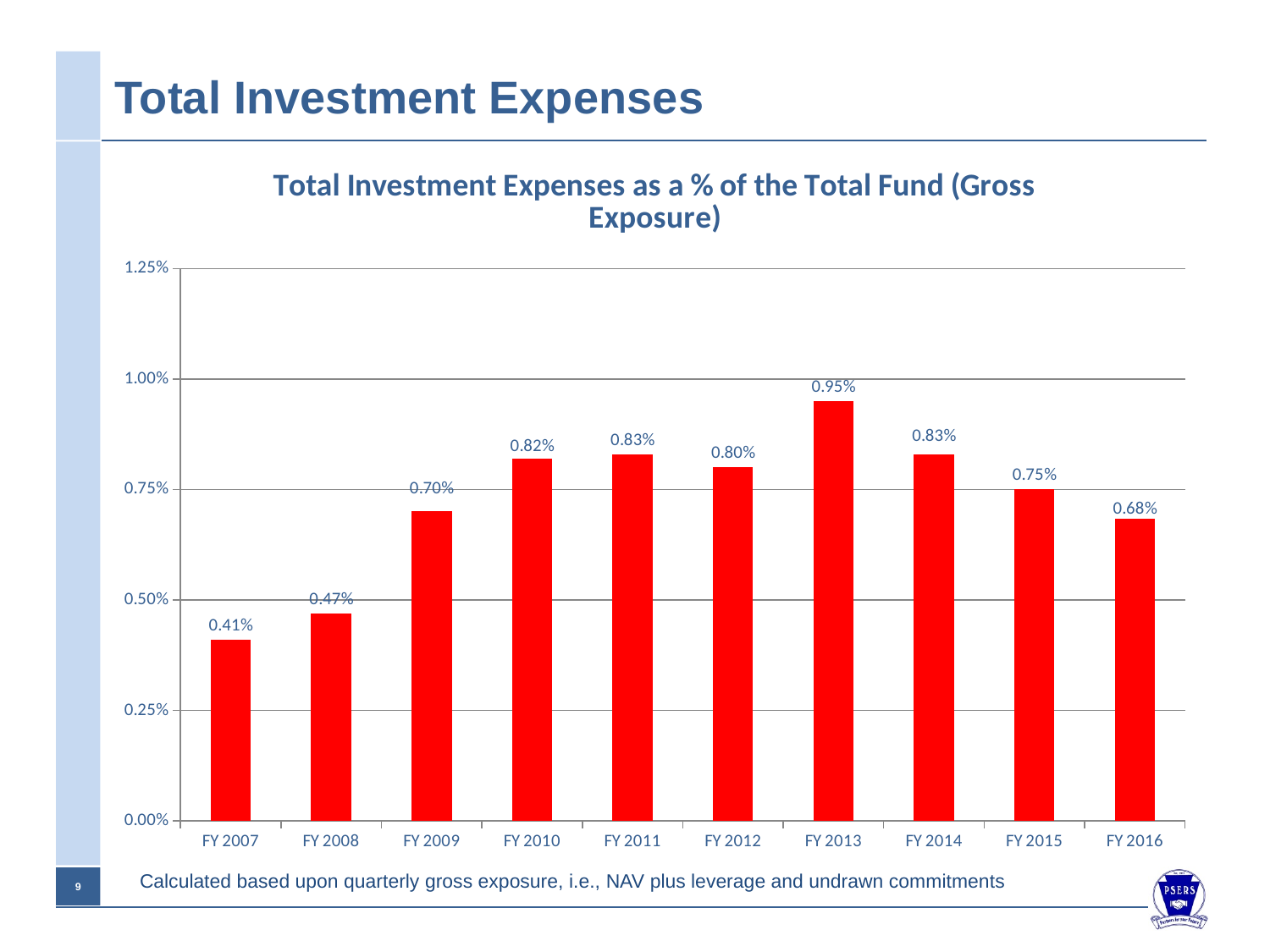
Do the values rise or fall from FY 2013 to FY 2016? fall Is the value for FY 2008 greater or less than 0.50%? less What is the value for FY 2016? 0.68% What is the title of the chart? Total Investment Expenses as a % of the Total Fund (Gross Exposure) How many fiscal years are shown on the chart? 10 What kind of chart is shown on the slide? bar chart What is the value for FY 2013? 0.95% Which is larger, the value for FY 2009 or the value for FY 2015? FY 2015 What is the value for FY 2007? 0.41% What is the difference between the values for FY 2013 and FY 2016? 0.27% Which fiscal year has the lowest total investment expenses as a % of the total fund? FY 2007 Which fiscal year has the highest total investment expenses as a % of the total fund? FY 2013